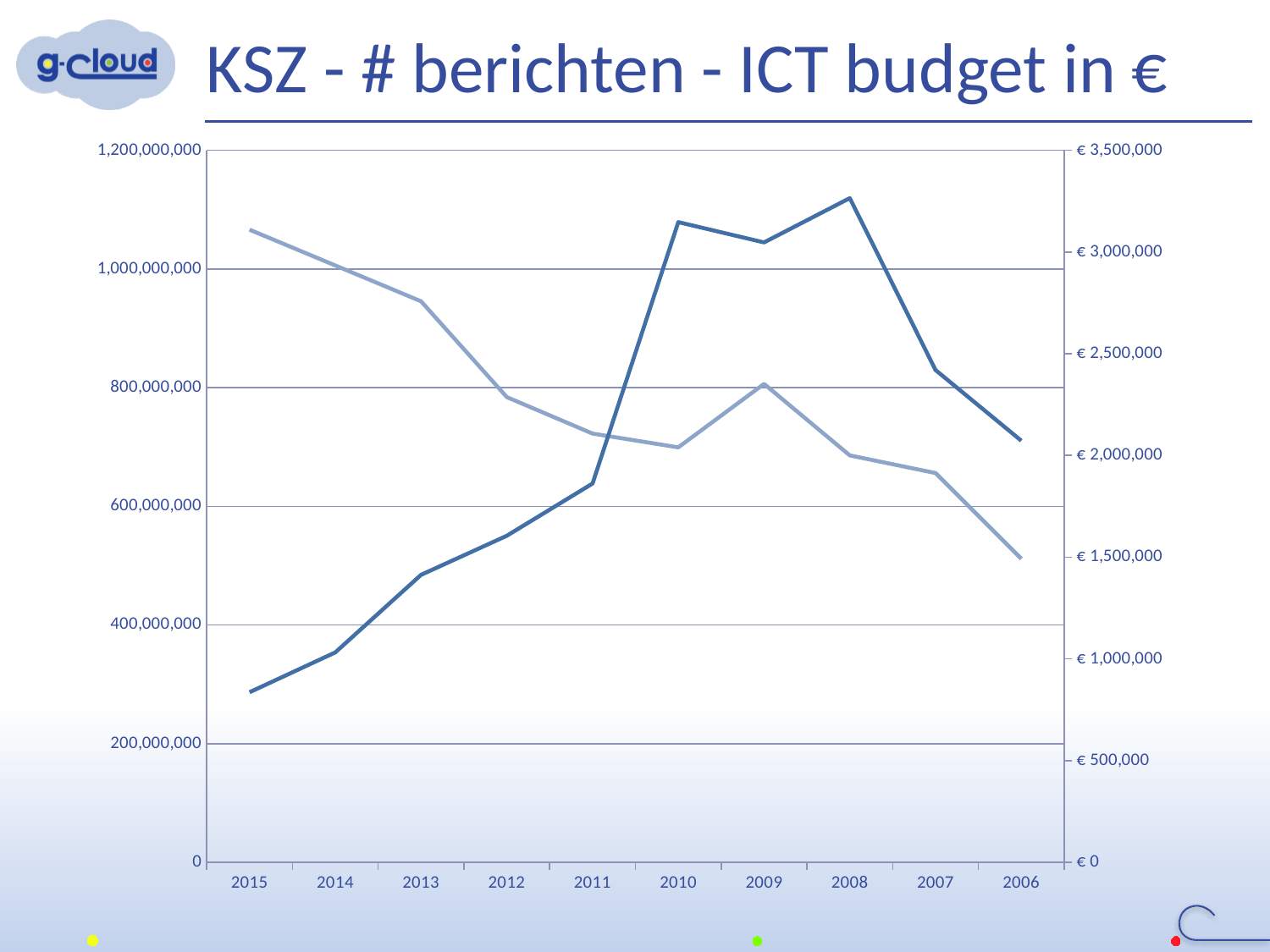
What is the highest tick value shown on the right-hand axis? € 3,500,000 In which year does the darker line reach its highest point? 2008 In which year is the lighter line at its lowest point? 2006 In which year is the darker line at its lowest point? 2015 In which year is the lighter line at its highest point? 2015 Does the lighter line generally rise or fall from 2015 to 2012 along the x axis? fall What is the title of the chart slide? KSZ - # berichten - ICT budget in € Is the lighter line higher in 2009 or in 2010? 2009 What kind of chart is shown on the slide? line chart How many years are shown on the x axis of the chart? 10 How many lines are plotted on the chart? 2 Is the darker line higher in 2010 or in 2011? 2010